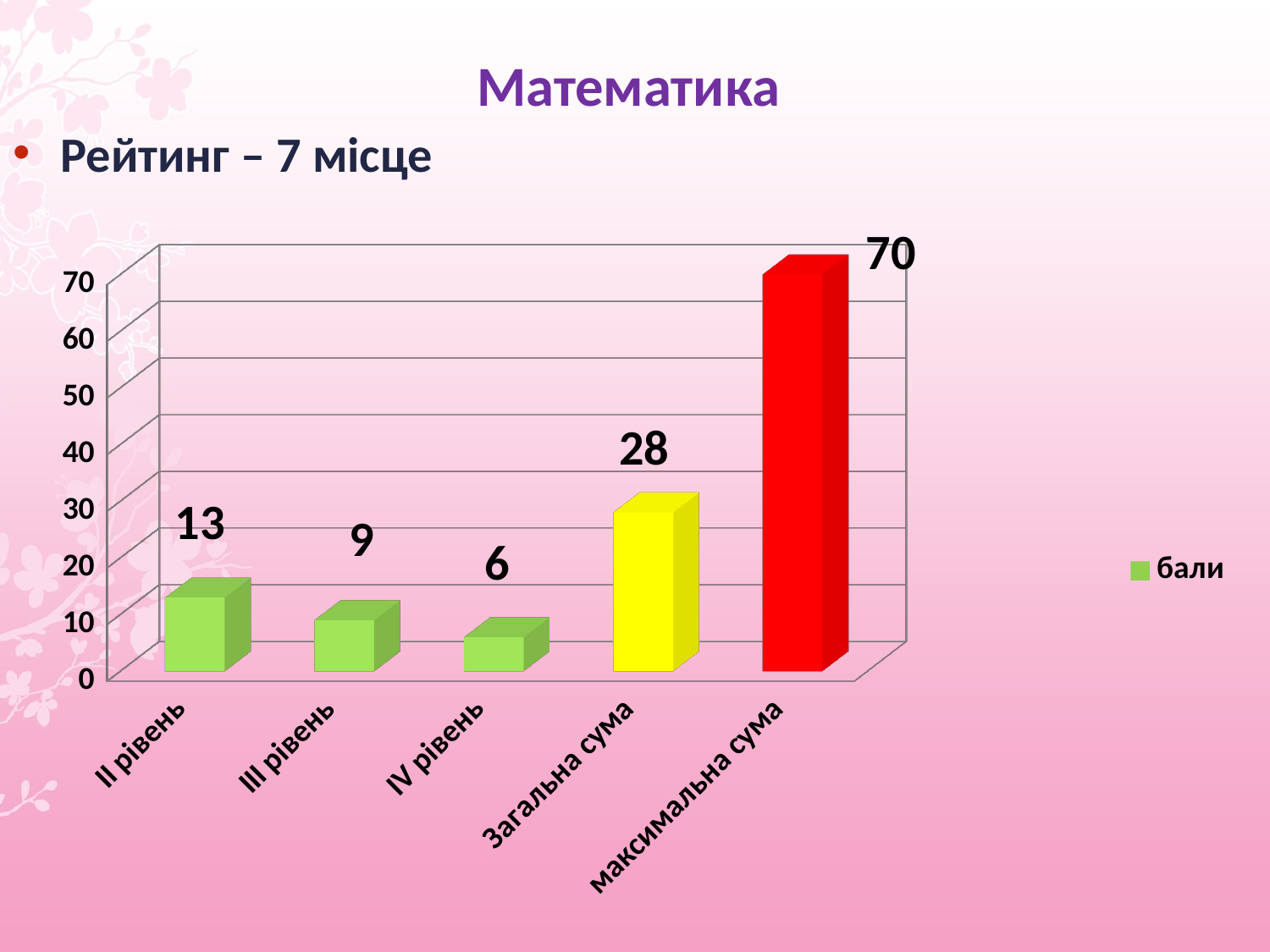
Which category has the lowest value? IV рівень What kind of chart is shown on the slide? bar chart What is the value for II рівень? 13 What is the value for IV рівень? 6 What is the value for максимальна сума? 70 What is the value for Загальна сума? 28 What is the difference between максимальна сума and Загальна сума? 42 Which is larger, II рівень or III рівень? II рівень Which category has the highest value? максимальна сума What series name does the legend show? бали What is the value for III рівень? 9 How many categories are shown on the x axis? 5